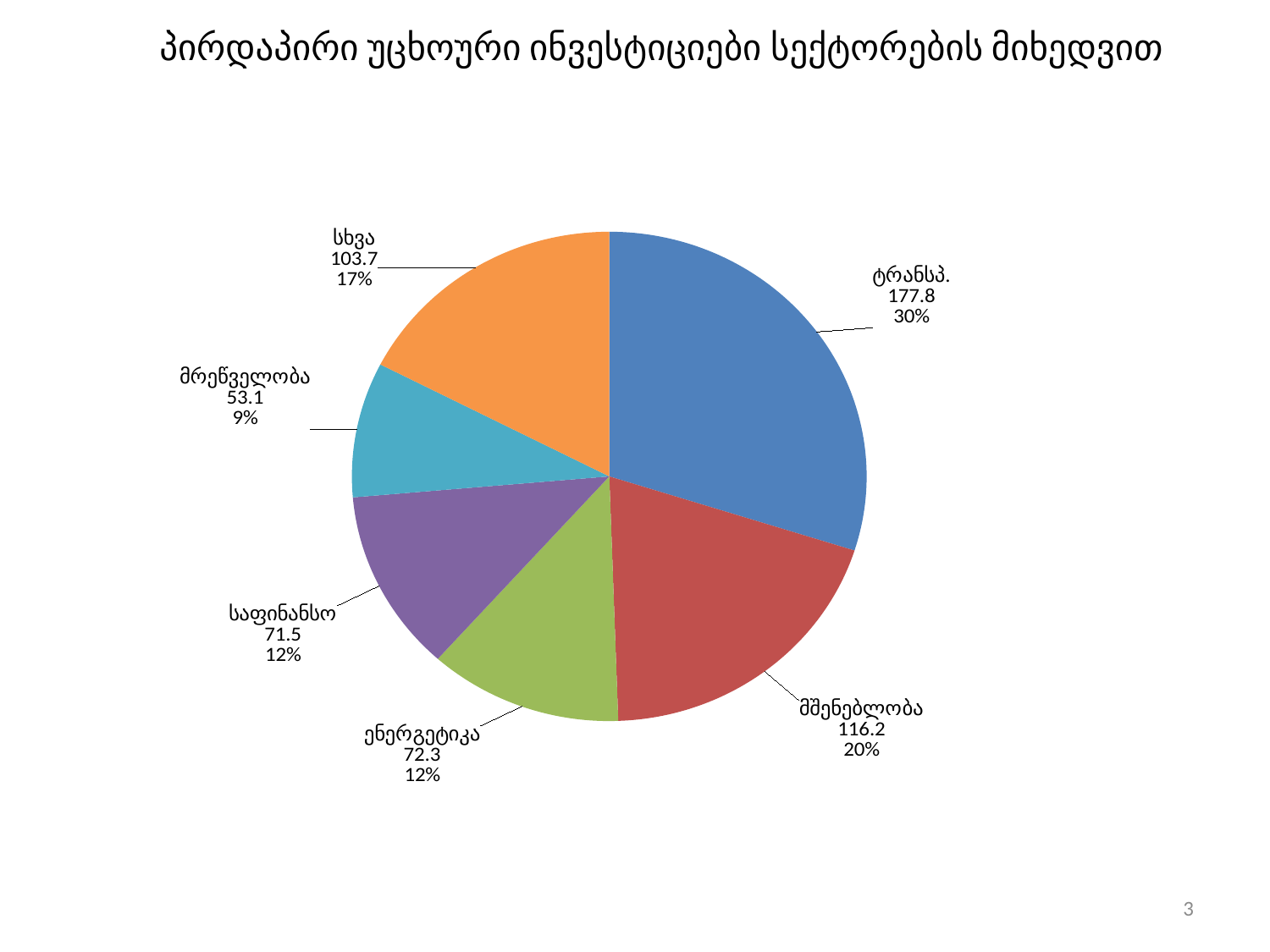
How many slices does the pie chart have? 6 What is the value for მრეწველობა? 53.1 What is the value for მშენებლობა? 116.2 What share of the pie does ენერგეტიკა represent? 12% Which sector has the smallest slice? მრეწველობა What is the value for ტრანსპ.? 177.8 Which is larger, the value for სხვა or the value for საფინანსო? სხვა Which sector has the largest slice? ტრანსპ. What type of chart is shown on the slide? pie chart What is the difference between the values for ტრანსპ. and მშენებლობა? 61.6 What is the value for სხვა? 103.7 What share of the pie does ტრანსპ. represent? 30%